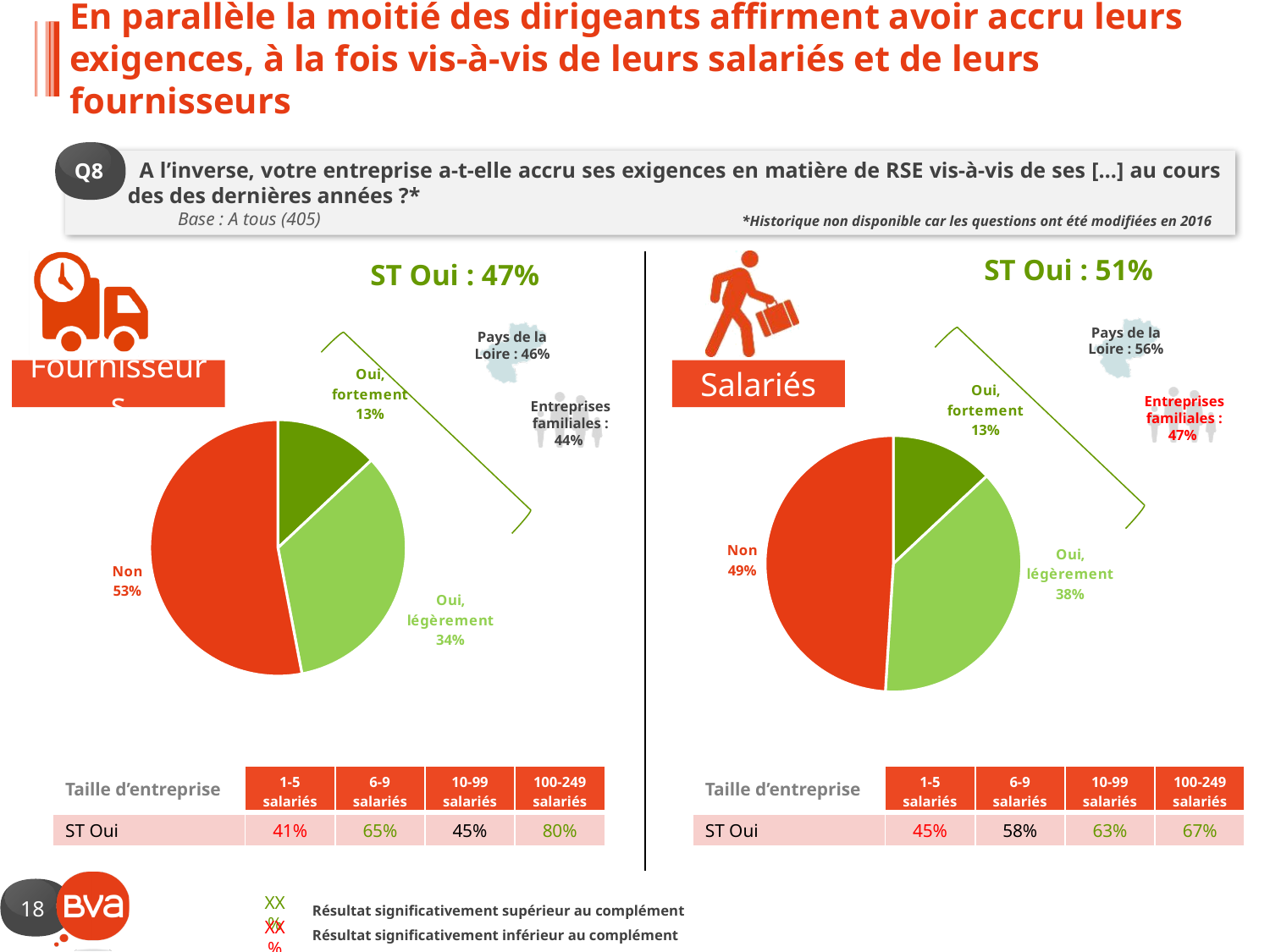
What kind of chart is used for the Salariés data on the right? Pie chart In the Fournisseurs pie chart on the left, what is the value for "Oui, fortement"? 13% In the Fournisseurs pie chart on the left, which category has the largest share? Non In the Fournisseurs pie chart on the left, what is the value for "Non"? 53% In the Fournisseurs pie chart on the left, what is the difference between "Non" and "Oui, légèrement"? 19% In the Salariés pie chart on the right, which category has the smallest share? Oui, fortement In the Salariés pie chart on the right, what is the difference between "Non" and "Oui, légèrement"? 11% In the Salariés pie chart on the right, what is the value for "Non"? 49% What colour is the "Non" slice in the Fournisseurs pie chart on the left? Red In the Salariés pie chart on the right, what is the value for "Oui, légèrement"? 38% How many slices does the Fournisseurs pie chart on the left have? 3 Which is larger: "Oui, légèrement" in the Fournisseurs chart on the left or "Oui, légèrement" in the Salariés chart on the right? Salariés